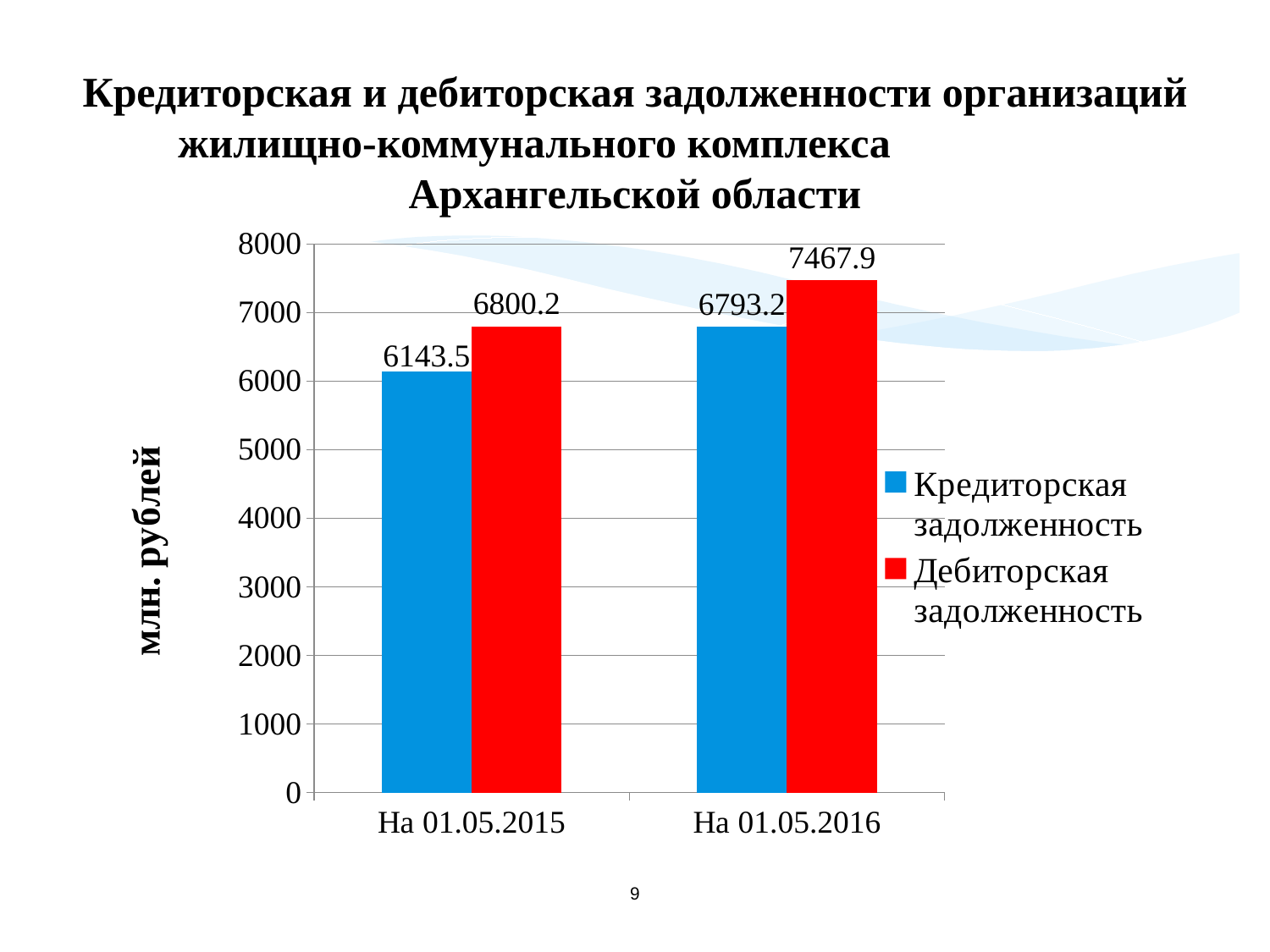
How many categories are shown on the x axis? 2 What is the value of Кредиторская задолженность for На 01.05.2015? 6143.5 Which bar has the lowest value on the chart? Кредиторская задолженность, На 01.05.2015 Which is larger for На 01.05.2015: Кредиторская задолженность or Дебиторская задолженность? Дебиторская задолженность What kind of chart is shown on the slide? Bar chart What is the value of Дебиторская задолженность for На 01.05.2016? 7467.9 Which bar has the highest value on the chart? Дебиторская задолженность, На 01.05.2016 What is the value of Кредиторская задолженность for На 01.05.2016? 6793.2 What is the difference between Дебиторская задолженность and Кредиторская задолженность for На 01.05.2016? 674.7 How many series does the legend list? 2 What is the label of the vertical axis? млн. рублей What is the value of Дебиторская задолженность for На 01.05.2015? 6800.2